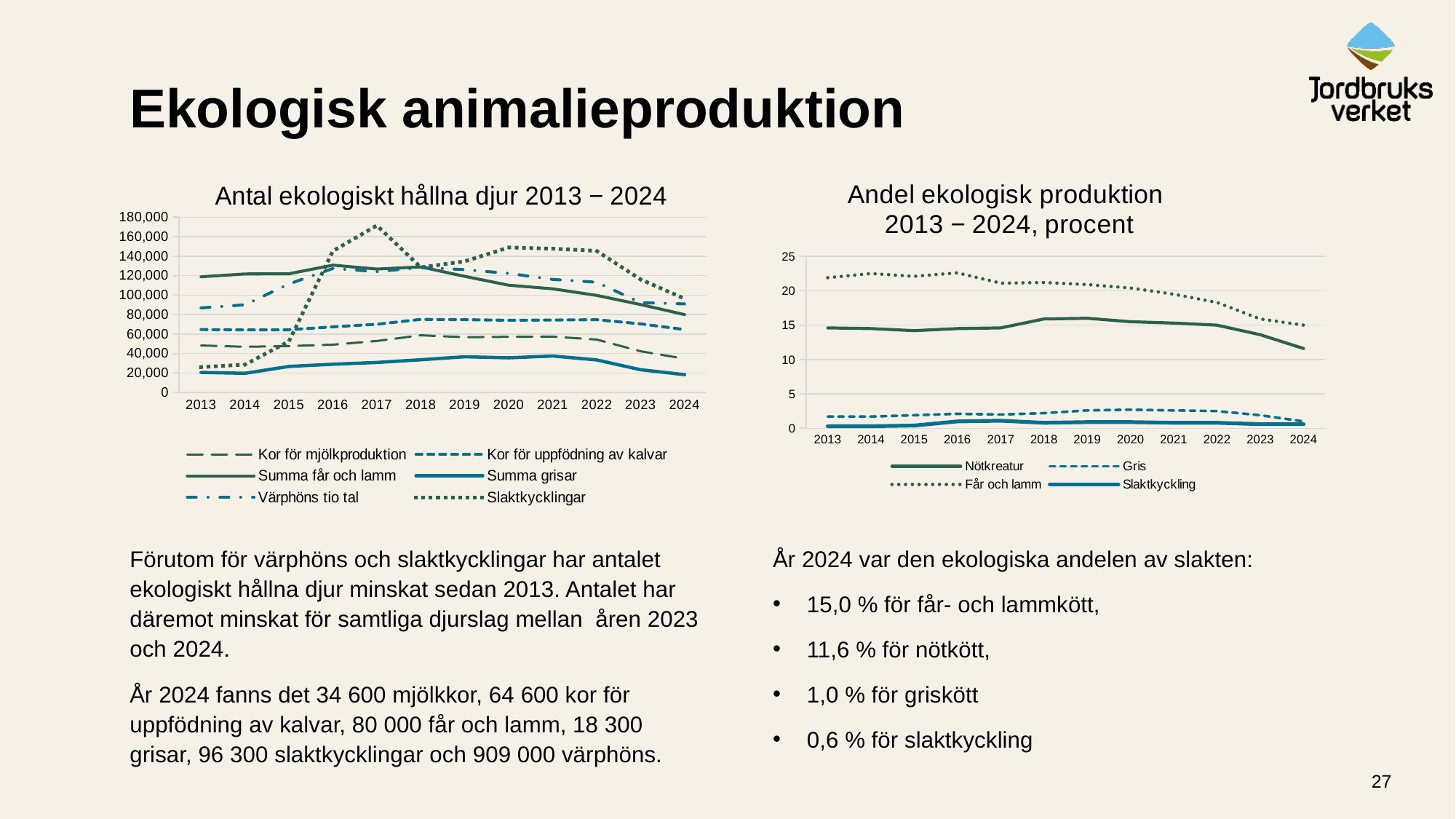
What kind of chart is the left chart titled 'Antal ekologiskt hållna djur 2013 − 2024'? line chart In the left chart 'Antal ekologiskt hållna djur 2013 − 2024', which is larger in 2024: Summa får och lamm or Kor för uppfödning av kalvar? Summa får och lamm In the right chart 'Andel ekologisk produktion 2013 − 2024, procent', is the value for Nötkreatur in 2024 greater or less than 15? less How many years are shown on the x axis of the right chart 'Andel ekologisk produktion 2013 − 2024, procent'? 12 How many series does the legend of the left chart 'Antal ekologiskt hållna djur 2013 − 2024' list? 6 In the left chart 'Antal ekologiskt hållna djur 2013 − 2024', is the value for Slaktkycklingar in 2017 greater or less than 160,000? greater In the right chart 'Andel ekologisk produktion 2013 − 2024, procent', is the value for Får och lamm in 2013 greater or less than 20? greater In the right chart 'Andel ekologisk produktion 2013 − 2024, procent', does the Nötkreatur series rise or fall from 2022 to 2024? fall How many series does the legend of the right chart 'Andel ekologisk produktion 2013 − 2024, procent' list? 4 In the right chart 'Andel ekologisk produktion 2013 − 2024, procent', which series has the highest value in 2024? Får och lamm In the left chart 'Antal ekologiskt hållna djur 2013 − 2024', which series has the lowest value in 2013? Summa grisar